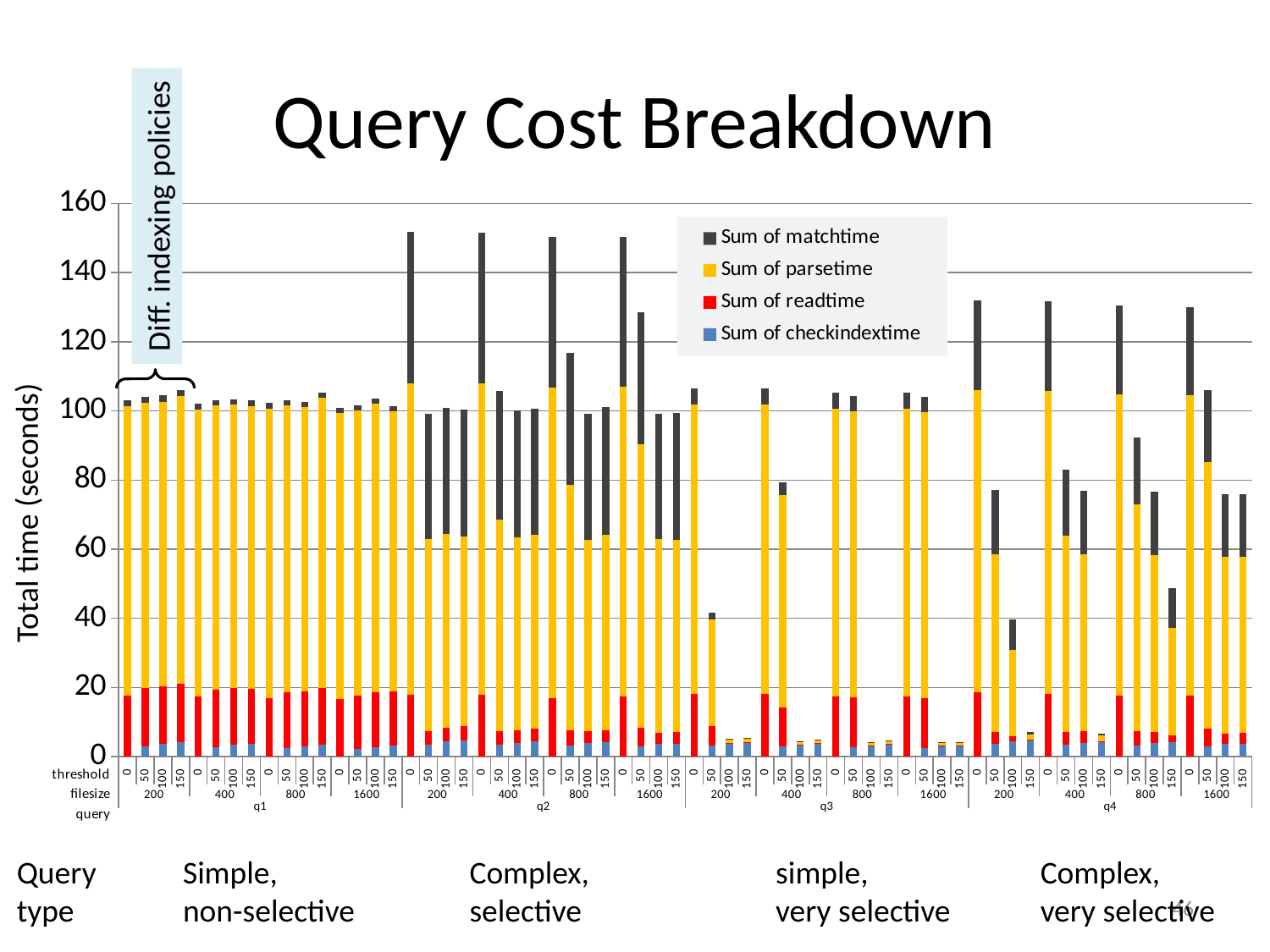
Is the total for q2, filesize 200, threshold 0 greater or less than 140? greater Which is larger: the total for q2, filesize 200, threshold 0 or the total for q3, filesize 200, threshold 0? q2, filesize 200, threshold 0 What is the label of the vertical axis? Total time (seconds) Is the total for q3, filesize 200, threshold 50 greater or less than 60? less What kind of chart is shown on the slide? Stacked bar chart Is the total for q3, filesize 200, threshold 100 greater or less than 20? less Which series does the legend list first? Sum of matchtime How many series does the legend list? 4 How many query groups (q1, q2, ...) are shown along the x axis? 4 What threshold values are listed for each filesize on the x axis? 0, 50, 100, 150 Within q4, filesize 200, do the bar totals rise or fall as the threshold increases from 0 to 150? fall